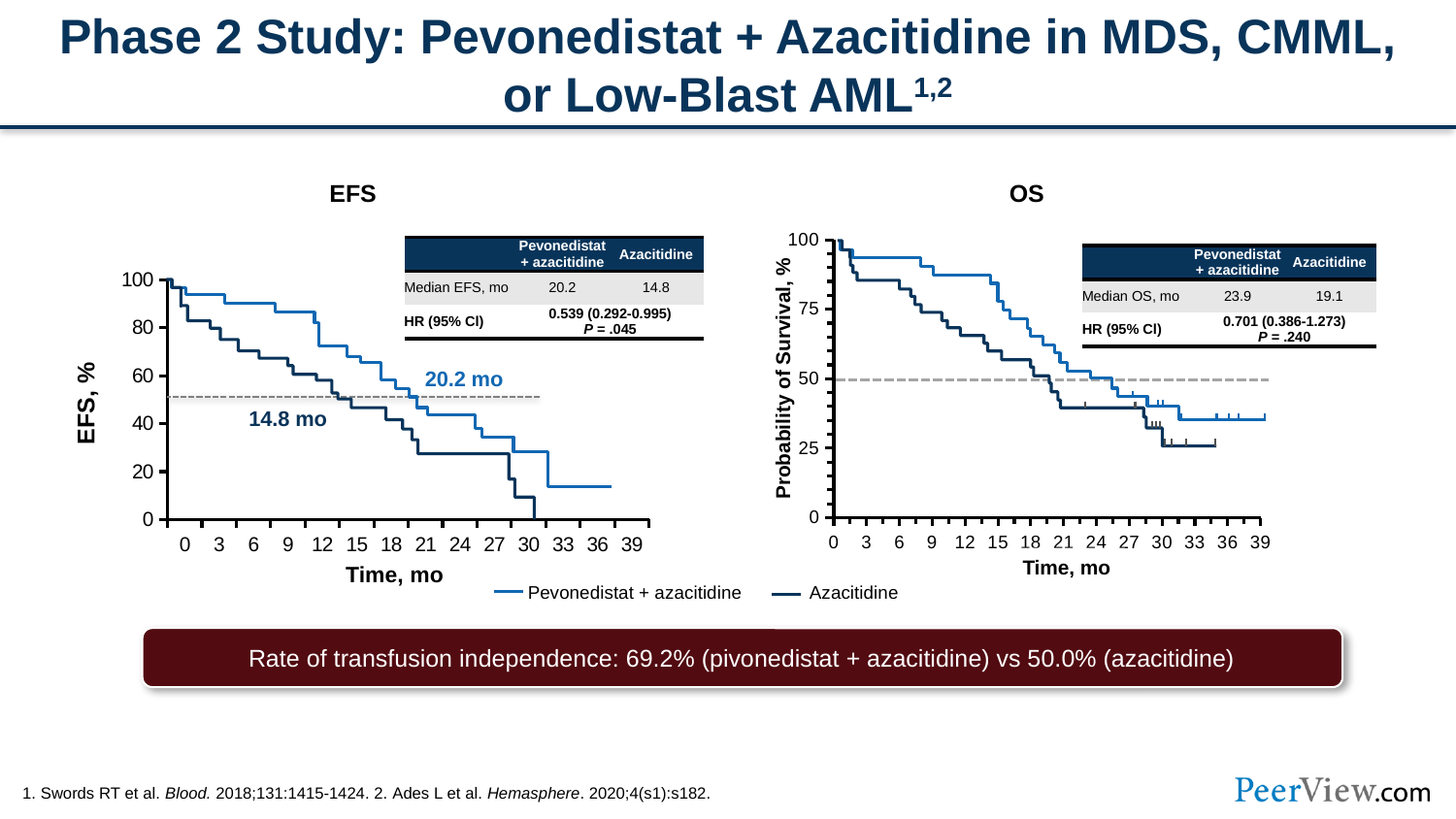
In the EFS chart, what is the difference in median EFS (months) between the pevonedistat + azacitidine arm and the azacitidine arm? 5.4 In the OS chart, what is the median OS in months for the pevonedistat + azacitidine arm? 23.9 In the EFS chart, what is the median EFS in months for the azacitidine arm? 14.8 In the OS chart, which arm has the longer median OS? Pevonedistat + azacitidine In the OS chart, what is the hazard ratio with its 95% CI? 0.701 (0.386-1.273) In the EFS chart, what is the median EFS in months for the pevonedistat + azacitidine arm? 20.2 What is the label of the x axis on the OS chart? Time, mo In the EFS chart, what is the P value shown for the hazard ratio? P = .045 In the EFS chart, what is the hazard ratio with its 95% CI? 0.539 (0.292-0.995) What kind of chart is the EFS chart? Line chart (Kaplan-Meier survival curve) How many series does the legend list for the survival curves? 2 In the OS chart, what is the median OS in months for the azacitidine arm? 19.1